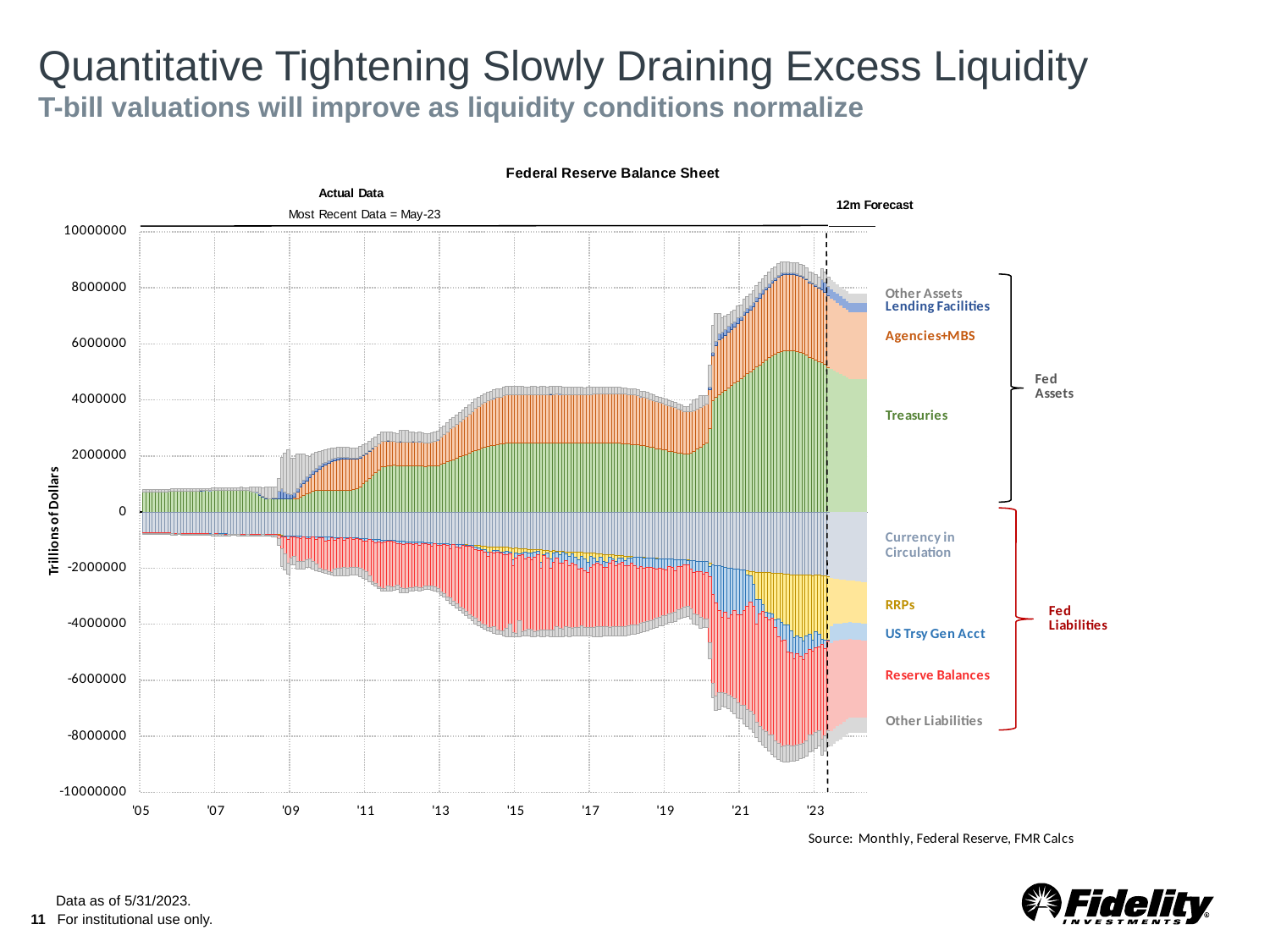
How many asset categories are labeled on the chart under Fed Assets? 4 What kind of chart is shown on the slide? Stacked bar chart Is the peak total of Fed Assets around 2022 greater or less than 8000000? greater How many year labels are shown along the x axis of the chart? 10 Which is larger in '23, the Treasuries segment or the Agencies+MBS segment? Treasuries Is the value for Treasuries in '15 greater or less than 2000000? greater Do total Fed Assets rise or fall from '05 to '22? rise What is the title of the chart? Federal Reserve Balance Sheet How many liability categories are labeled on the chart under Fed Liabilities? 5 Do Treasuries rise or fall from '09 to '15? rise What is the label on the vertical axis of the chart? Trillions of Dollars Is the total of Fed Assets in '05 greater or less than 2000000? less